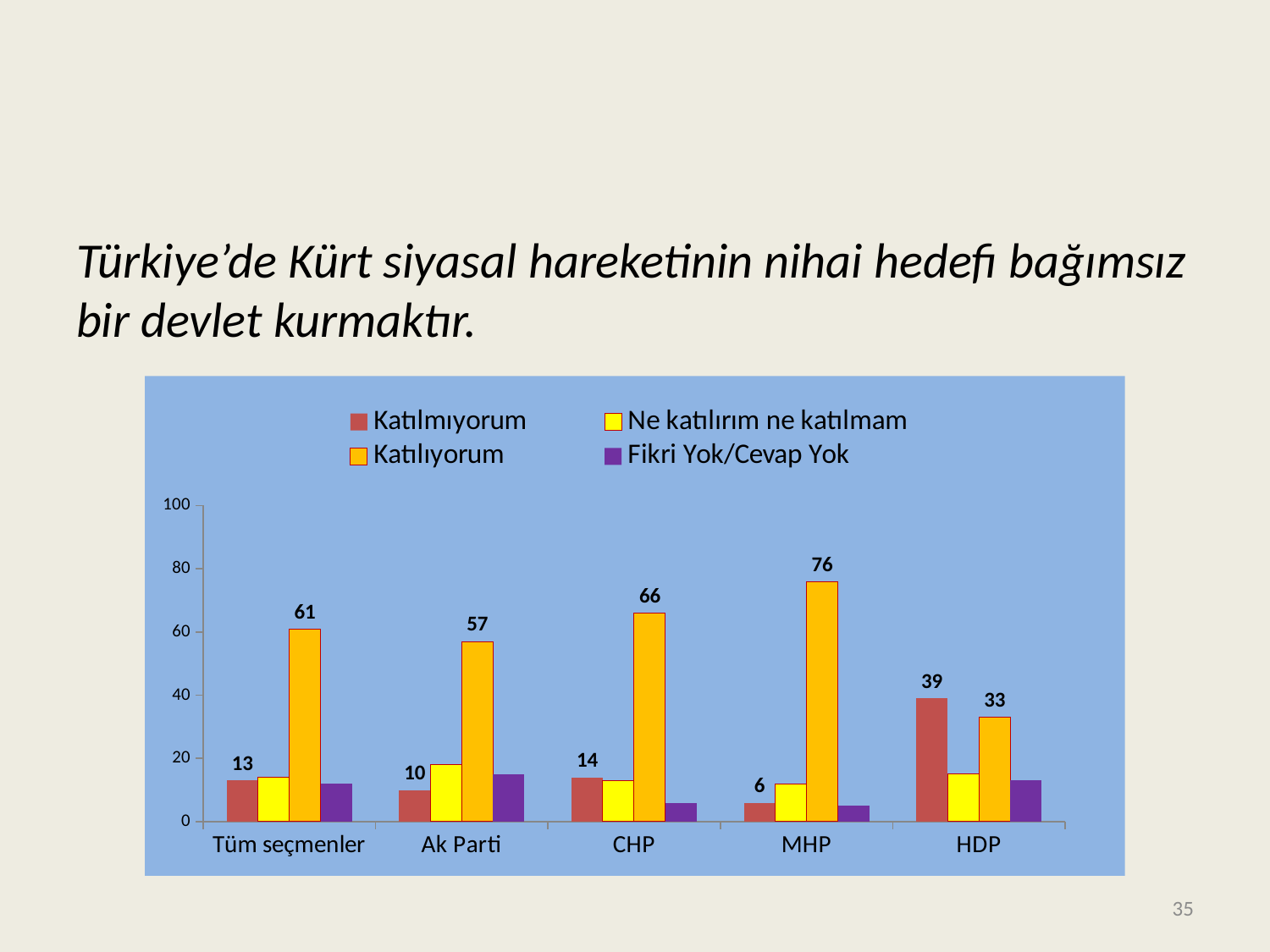
How many categories are shown on the x axis? 5 What is the difference between the Katılıyorum values for CHP and HDP? 33 Which category has the highest Katılıyorum value? MHP Which is larger for HDP: Katılmıyorum or Katılıyorum? Katılmıyorum How many series does the legend list? 4 What is the value of Katılıyorum for Ak Parti? 57 Which category has the lowest Katılmıyorum value? MHP What is the value of Katılıyorum for MHP? 76 What is the value of Katılmıyorum for HDP? 39 Which colour represents the Fikri Yok/Cevap Yok series? purple Is the Ne katılırım ne katılmam value for Ak Parti greater or less than 40? less What kind of chart is shown on the slide? bar chart